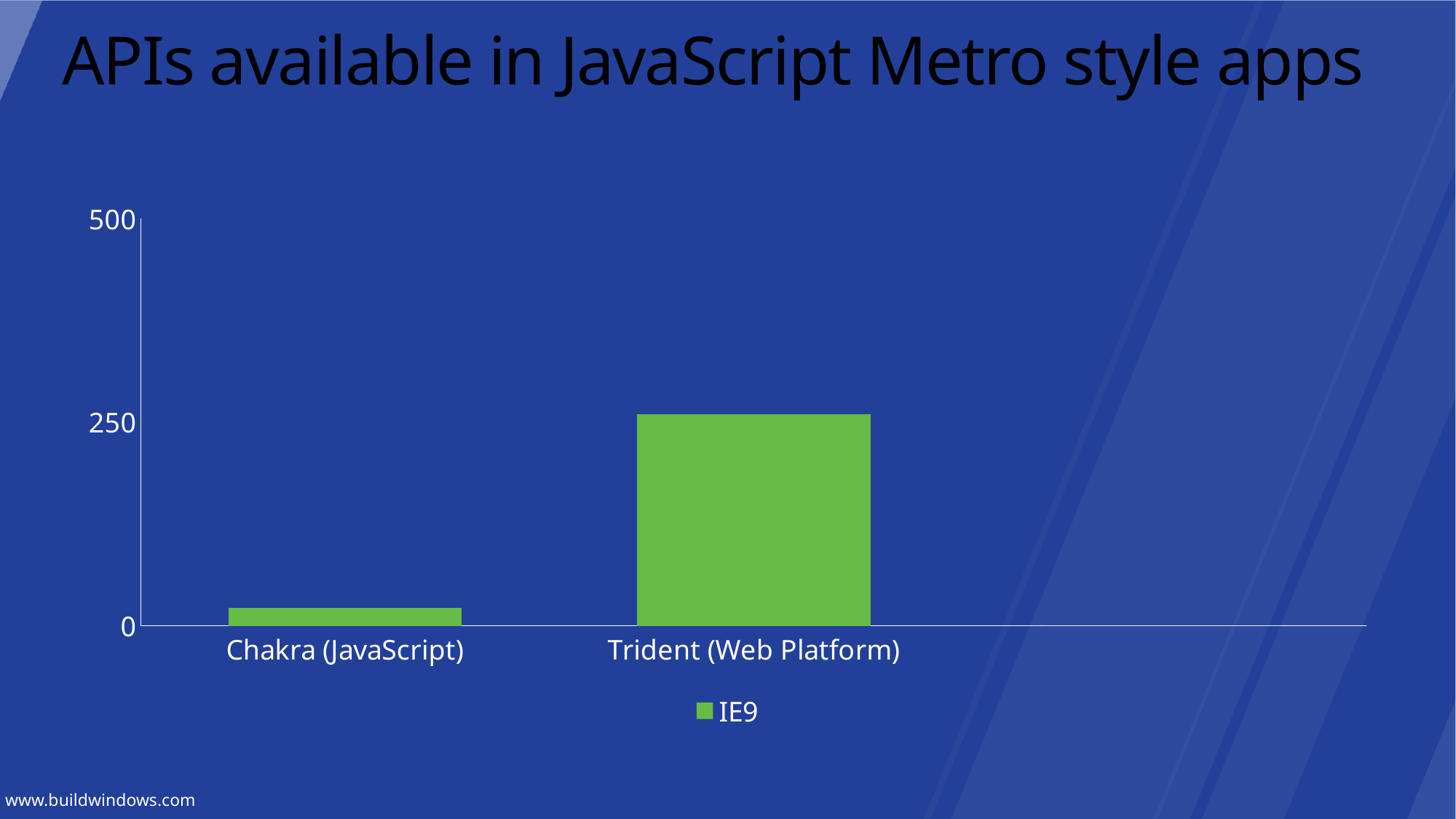
Which category has the highest value? Trident (Web Platform) Is the value for Chakra (JavaScript) greater or less than 250? less Do the values rise or fall from Chakra (JavaScript) to Trident (Web Platform)? rise How many categories are shown on the x axis? 2 Is the value for Trident (Web Platform) greater or less than 500? less What type of chart is shown on the slide? bar chart What series name is shown in the legend? IE9 What is the title of the chart? APIs available in JavaScript Metro style apps Which category has the lowest value? Chakra (JavaScript) Which is larger, the value for Chakra (JavaScript) or the value for Trident (Web Platform)? Trident (Web Platform) How many series does the legend list? 1